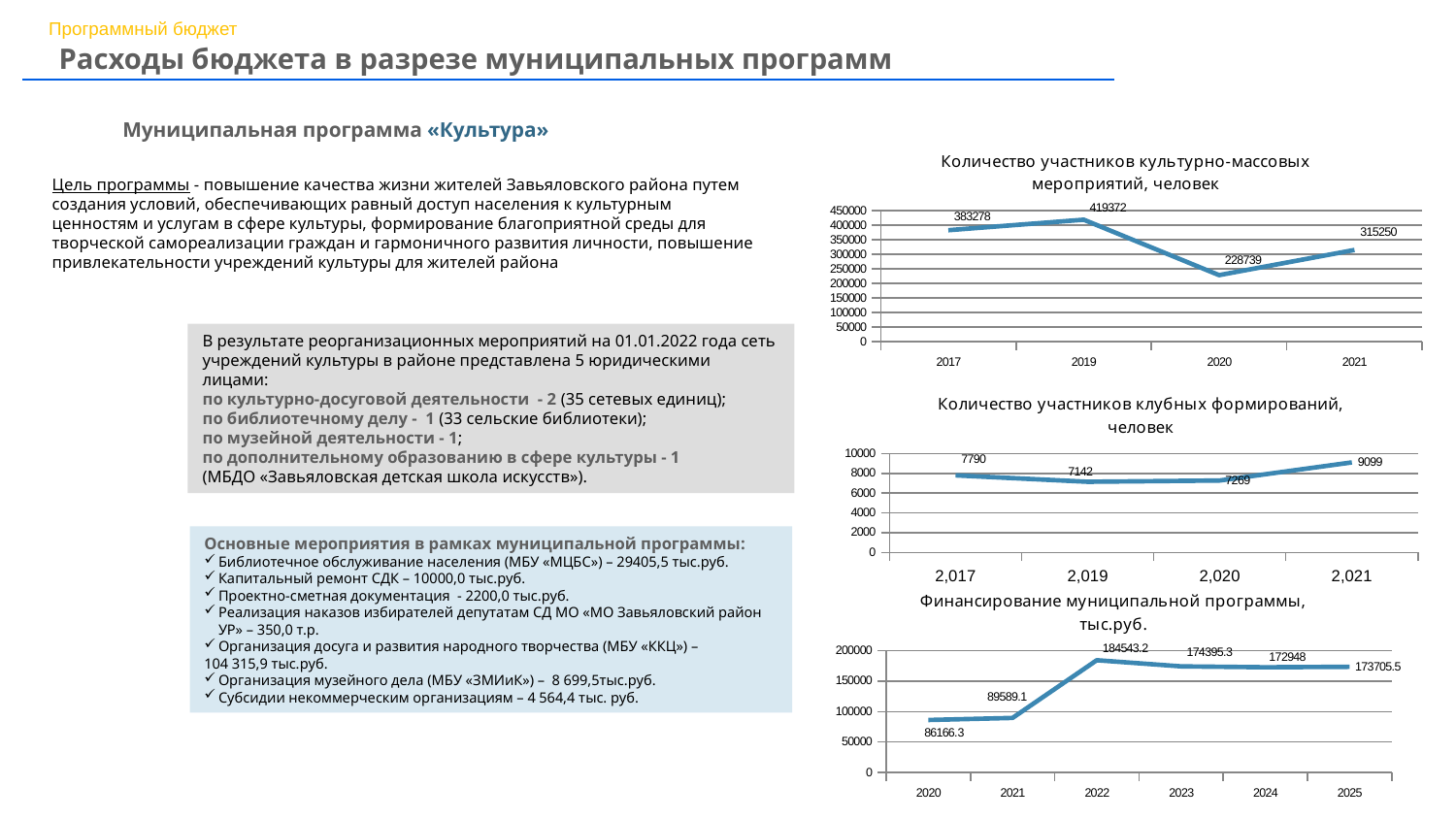
On the chart 'Количество участников клубных формирований, человек', is the value for 2017 larger or the value for 2019? 2017 On the chart 'Финансирование муниципальной программы, тыс.руб.', which year has the lowest value? 2020 What type of chart is 'Финансирование муниципальной программы, тыс.руб.'? line chart On the chart 'Количество участников культурно-массовых мероприятий, человек', what is the value for 2019? 419372 On the chart 'Финансирование муниципальной программы, тыс.руб.', how many years are shown on the x axis? 6 On the chart 'Количество участников клубных формирований, человек', which year has the highest value? 2021 On the chart 'Финансирование муниципальной программы, тыс.руб.', what is the value for 2022? 184543.2 On the chart 'Финансирование муниципальной программы, тыс.руб.', do the values rise or fall from 2021 to 2022? rise On the chart 'Количество участников культурно-массовых мероприятий, человек', what is the difference between the 2019 and 2020 values? 190633 On the chart 'Количество участников клубных формирований, человек', what is the value for 2021? 9099 On the chart 'Количество участников культурно-массовых мероприятий, человек', how many data points are plotted? 4 On the chart 'Количество участников культурно-массовых мероприятий, человек', which year has the lowest value? 2020